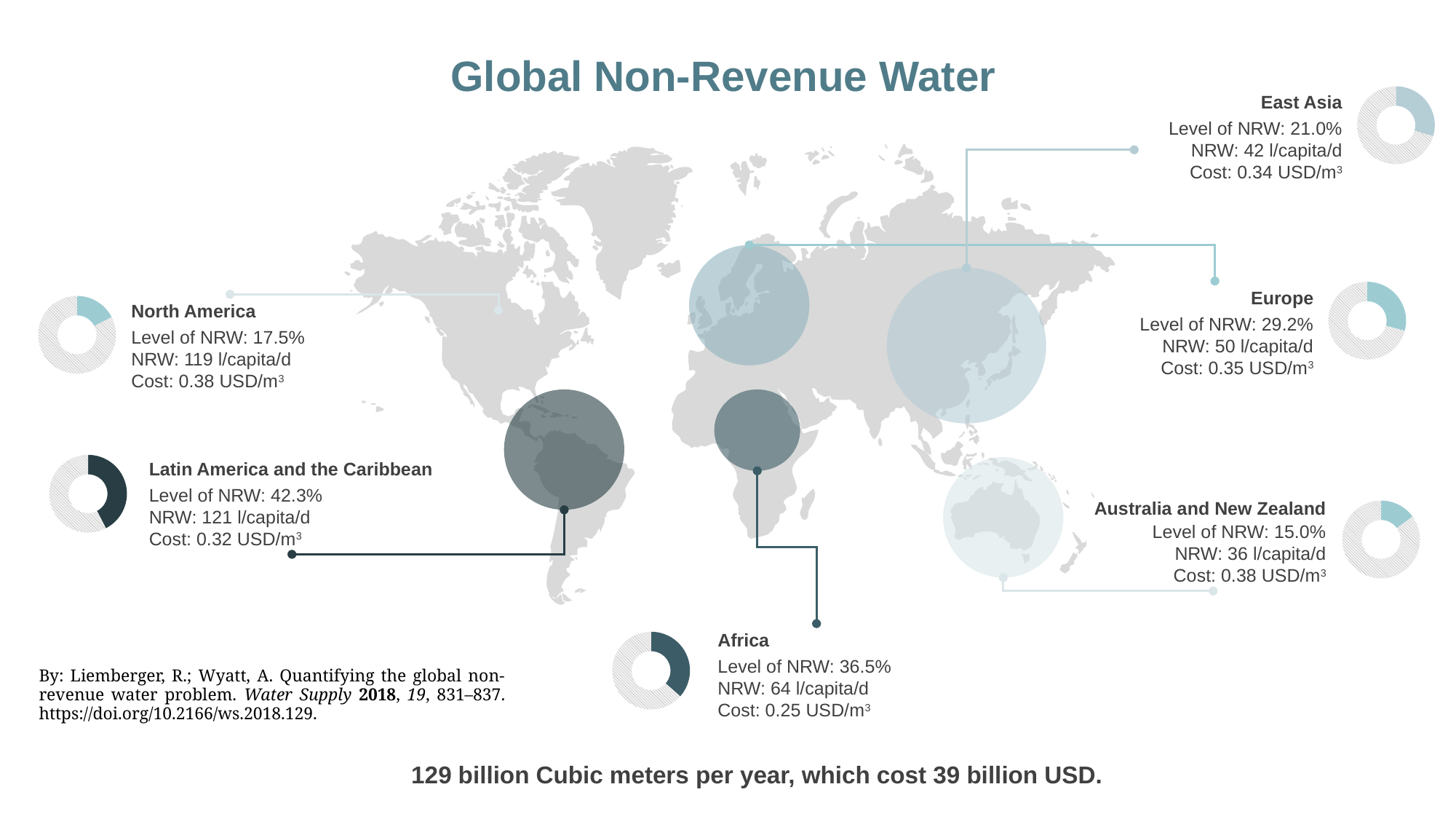
What is the difference in NRW l/capita/d between Latin America and the Caribbean and East Asia? 79 l/capita/d What is the NRW per capita value shown for Europe? 50 l/capita/d Which region has the lowest Level of NRW? Australia and New Zealand What is the difference in Level of NRW between Africa and North America? 19.0% What is the Level of NRW shown for East Asia? 21.0% What kind of chart is used to show the Level of NRW for each region? Donut chart What is the Level of NRW shown for Latin America and the Caribbean? 42.3% Which has a higher Level of NRW, Europe or East Asia? Europe How many regions are shown with donut charts on the slide? 6 Which region has the lowest Cost in USD/m³? Africa What is the Cost shown for Africa? 0.25 USD/m³ Which region has the highest Level of NRW? Latin America and the Caribbean